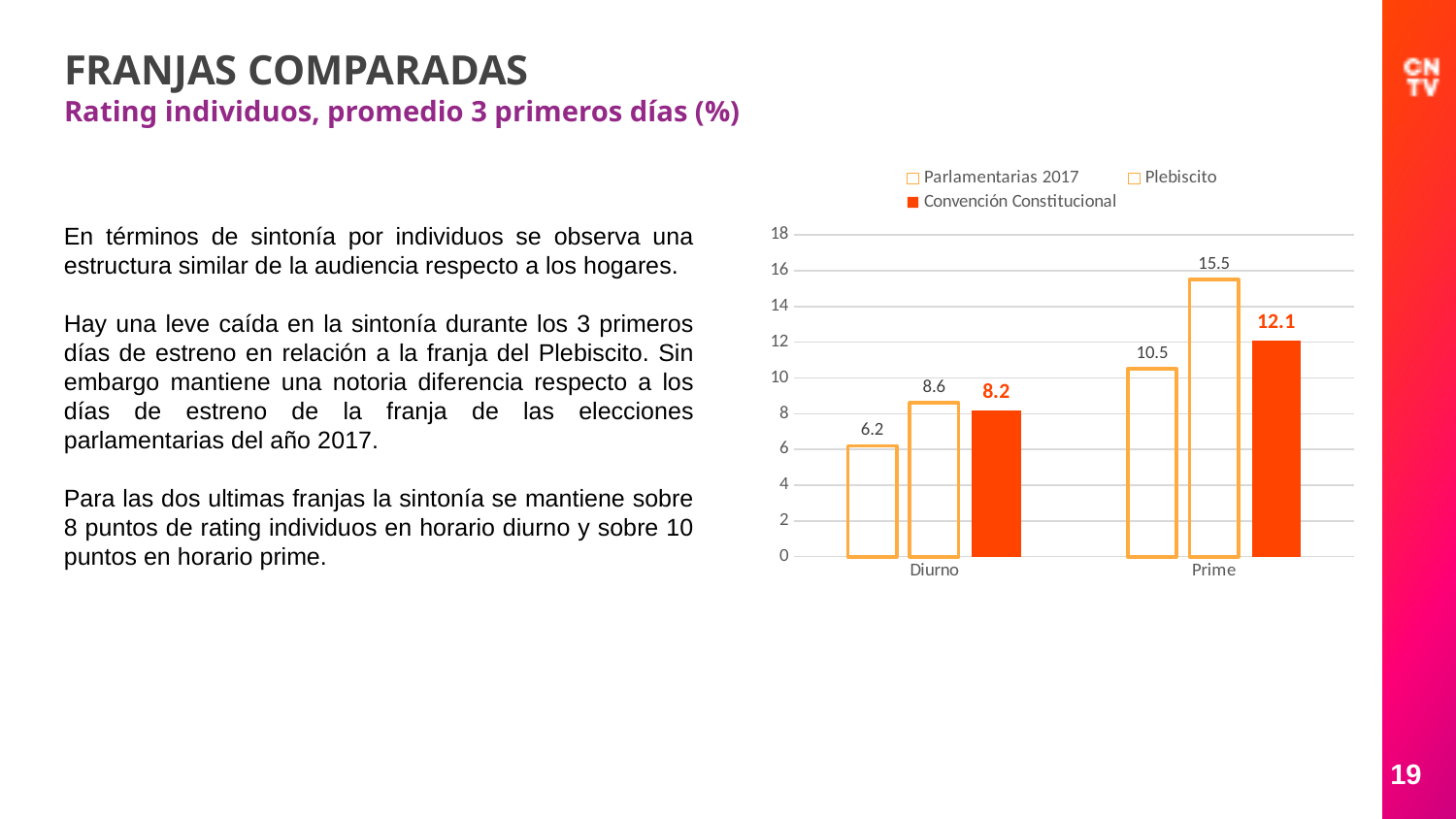
What is the value for Convención Constitucional in the Diurno category? 8.2 How many series does the legend list? 3 Which series has the lowest value in the Diurno category? Parlamentarias 2017 What is the difference between the Plebiscito and Convención Constitucional values in the Diurno category? 0.4 What is the difference between the Plebiscito and Parlamentarias 2017 values in the Prime category? 5 What is the value for Parlamentarias 2017 in the Diurno category? 6.2 Which is larger: Parlamentarias 2017 in Prime or Plebiscito in Diurno? Parlamentarias 2017 in Prime Which series has the highest value in the Prime category? Plebiscito What kind of chart is shown on the slide? Bar chart How many categories are shown on the x axis? 2 What is the value for Convención Constitucional in the Prime category? 12.1 What is the value for Plebiscito in the Prime category? 15.5